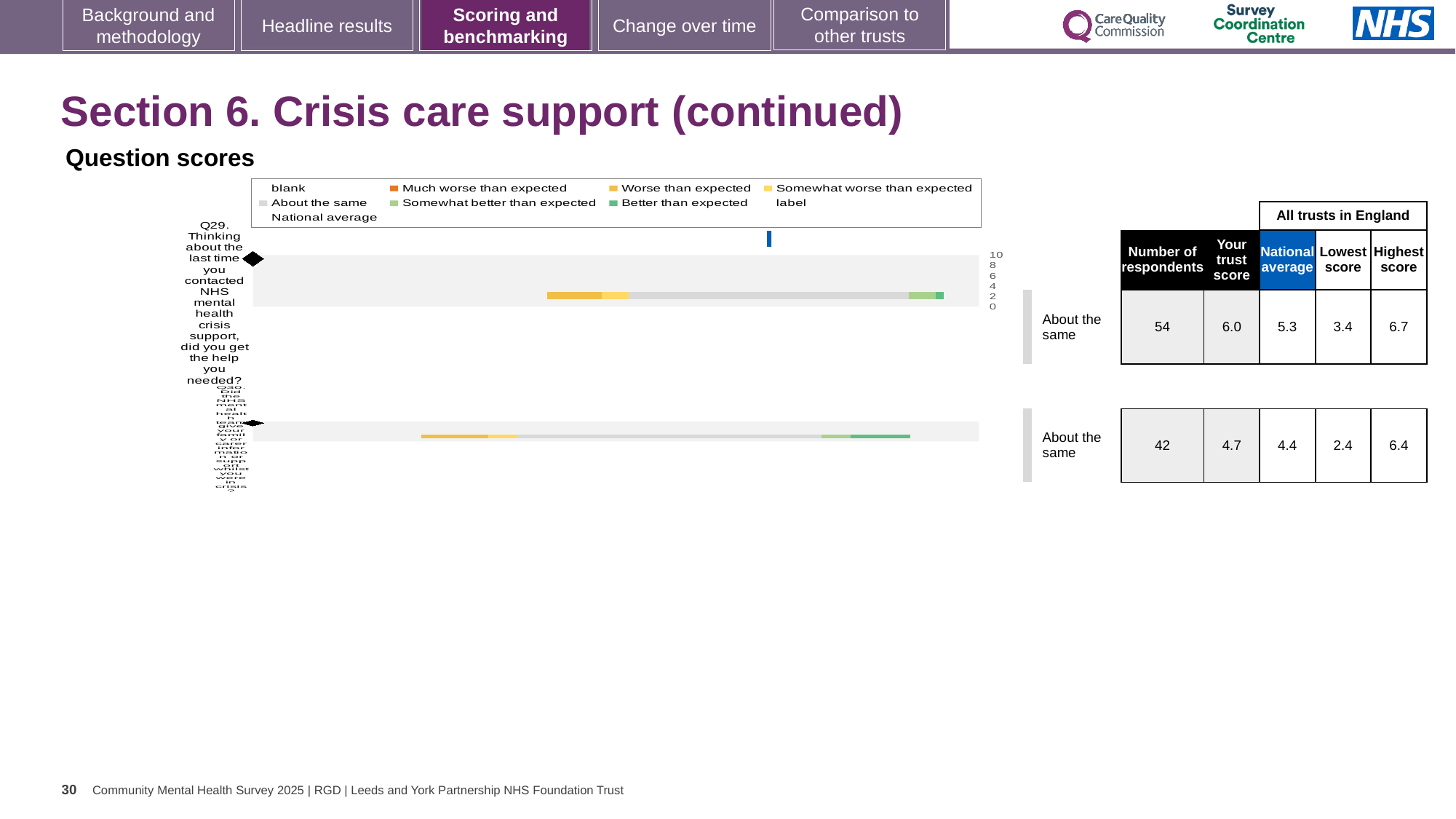
How many respondents answered Q30? 42 What is the trust score for Q30 (Did the NHS mental health team give your family or carer information or support whilst you were in crisis?)? 4.7 What is the national average score for Q29? 5.3 How many entries does the legend of the question scores chart list? 9 By how much does the trust score for Q29 exceed the national average for Q29? 0.7 Which question has the higher trust score, Q29 or Q30? Q29 How many questions are plotted in the question scores chart? 2 What kind of chart is used to show the question scores on this slide? Bar chart Which benchmark category is shown for Q29? About the same Which question has the higher national average, Q29 or Q30? Q29 What is the trust score for Q29 (Thinking about the last time you contacted NHS mental health crisis support, did you get the help you needed?)? 6.0 What is the difference between the highest score and the lowest score for Q30 across all trusts in England? 4.0